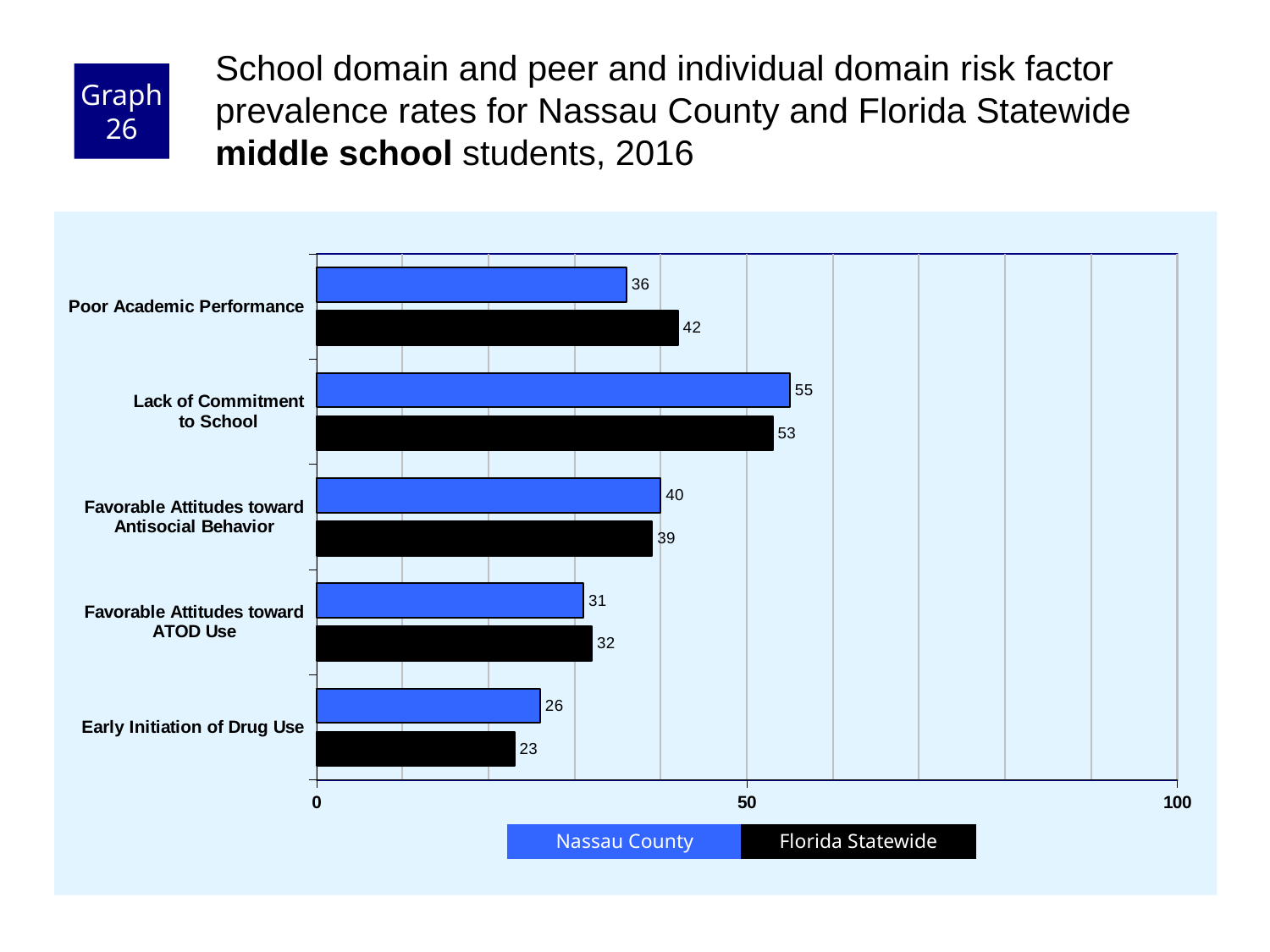
How many risk factors are shown on the chart? 5 Which risk factor has the highest Nassau County value? Lack of Commitment to School What is the Florida Statewide value for Early Initiation of Drug Use? 23 What kind of chart is shown on the slide? bar chart Is the Nassau County value for Lack of Commitment to School greater or less than 50? greater How many series does the legend list? 2 Which colour represents Florida Statewide in the chart? black Which risk factor has the lowest Florida Statewide value? Early Initiation of Drug Use What is the Nassau County value for Poor Academic Performance? 36 What is the Florida Statewide value for Lack of Commitment to School? 53 For Early Initiation of Drug Use, which is larger: the Nassau County value or the Florida Statewide value? Nassau County What is the difference between the Florida Statewide and Nassau County values for Poor Academic Performance? 6